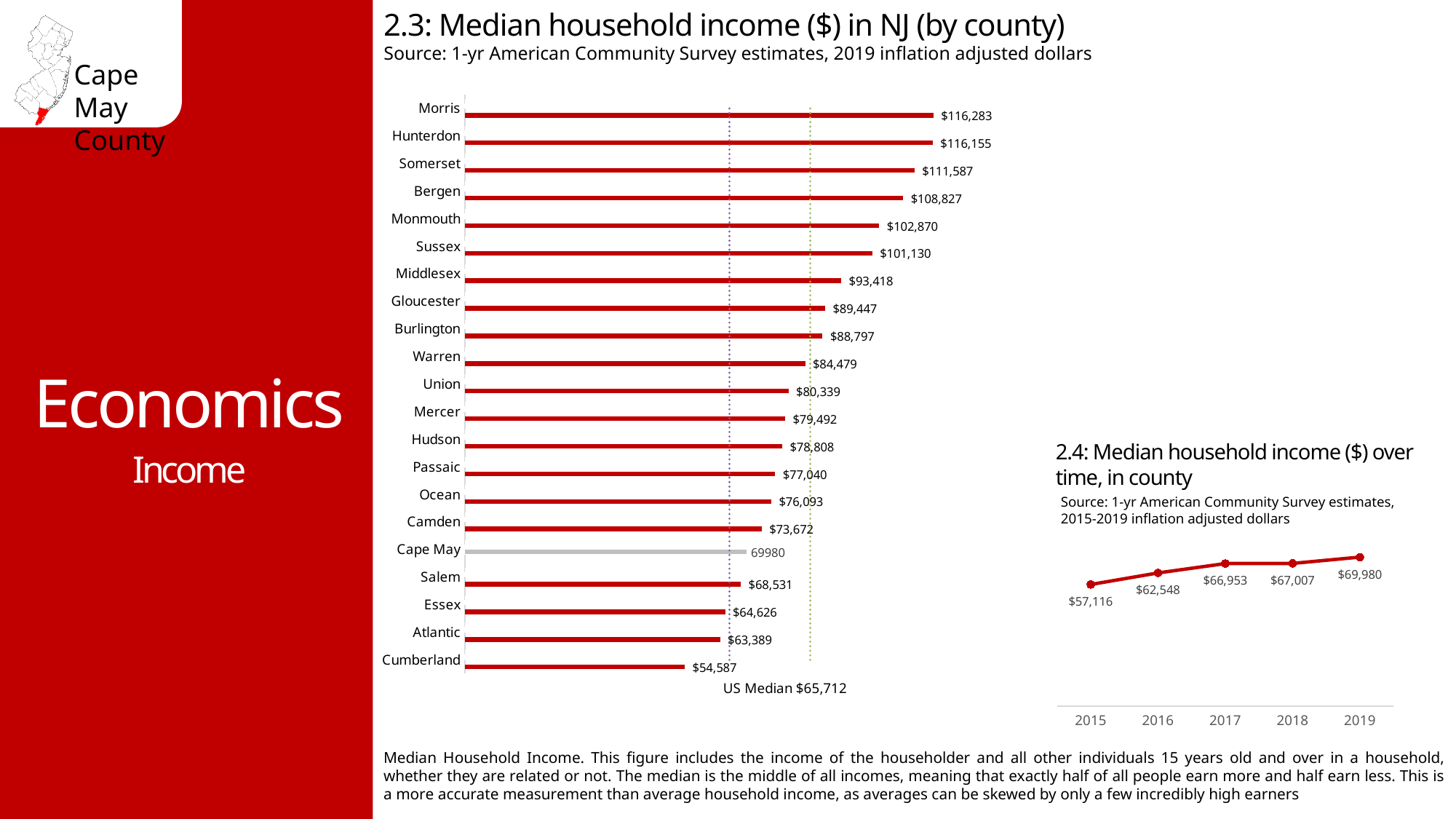
In chart 2.3 (Median household income in NJ by county), which county has the highest median household income? Morris In chart 2.3 (Median household income in NJ by county), how many counties are shown? 21 In chart 2.3 (Median household income in NJ by county), what is the difference between Bergen's and Camden's median household income? $35,155 In chart 2.4 (Median household income over time, in county), what is the difference between the 2019 and 2018 values? $2,973 In chart 2.3 (Median household income in NJ by county), which county has a higher median household income, Gloucester or Ocean? Gloucester In chart 2.3 (Median household income in NJ by county), what value is shown for Cape May? 69980 In chart 2.3 (Median household income in NJ by county), what US median value is labeled on the chart? $65,712 In chart 2.4 (Median household income over time, in county), what was the median household income in 2015? $57,116 In chart 2.3 (Median household income in NJ by county), which county has the lowest median household income? Cumberland What type of chart is chart 2.3 (Median household income in NJ by county)? Bar chart In chart 2.3 (Median household income in NJ by county), what is the median household income for Morris? $116,283 In chart 2.4 (Median household income over time, in county), does the median household income rise or fall from 2015 to 2019? Rise